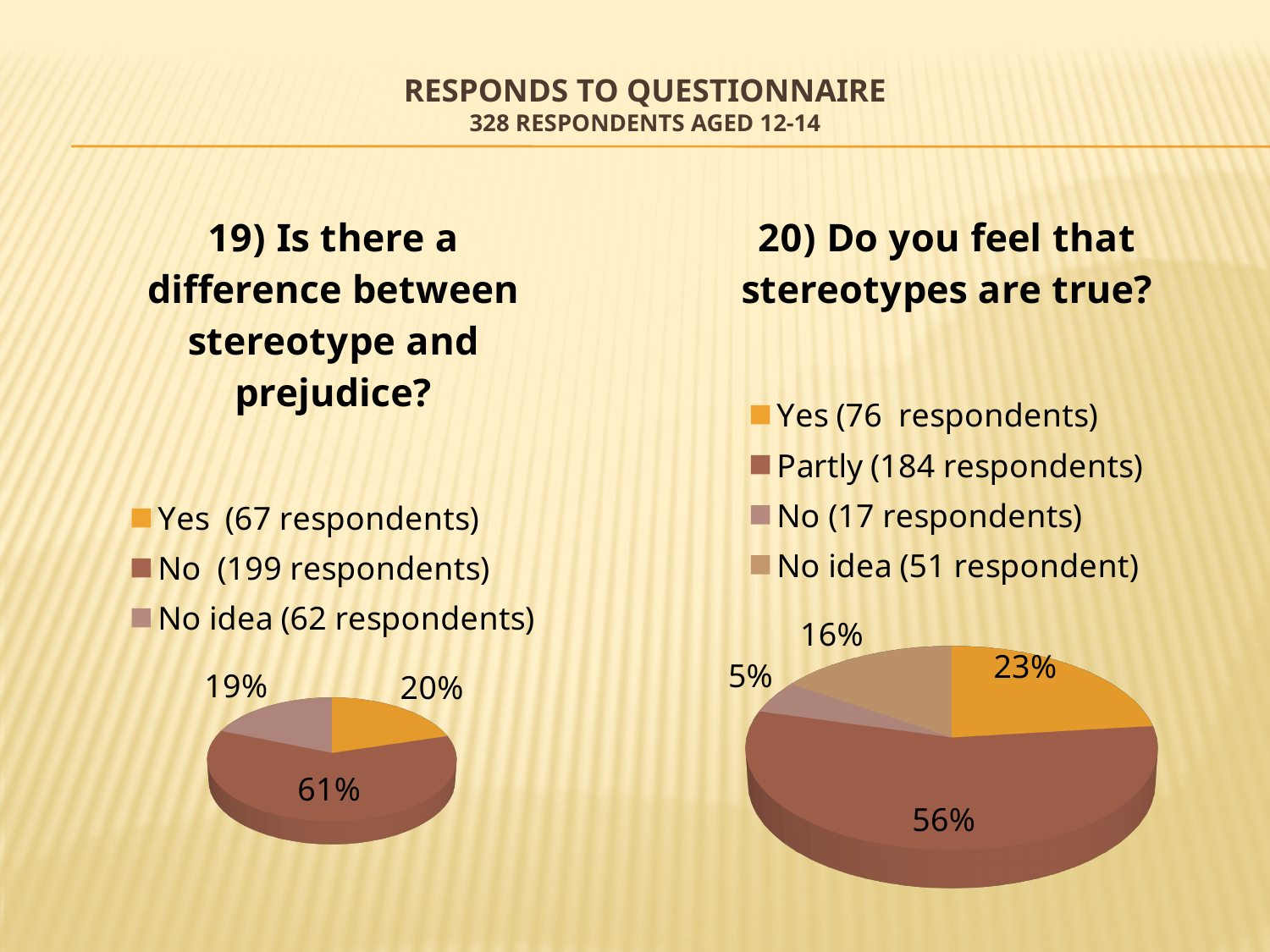
In the chart for question 19 (left), what is the difference in percentage points between the "No" and "Yes" shares? 41 In the chart for question 19 (left), what percentage of respondents answered "No"? 61% In the chart for question 19 (left), which answer has the smallest share? No idea How many categories does the legend of the chart for question 20 (right) list? 4 What type of chart is used for question 19 (left)? Pie chart In the chart for question 20 (right), which answer has the smallest share? No In the chart for question 20 (right), which answer has the largest share? Partly In the chart for question 20 (right), what percentage of respondents answered "Partly"? 56% In the chart for question 19 (left), what percentage of respondents answered "Yes"? 20% In the chart for question 20 (right), what percentage of respondents answered "No"? 5% In the chart for question 19 (left), how many respondents answered "No idea" according to the legend? 62 In the chart for question 20 (right), which is larger: the share for "Yes" or the share for "No idea"? Yes